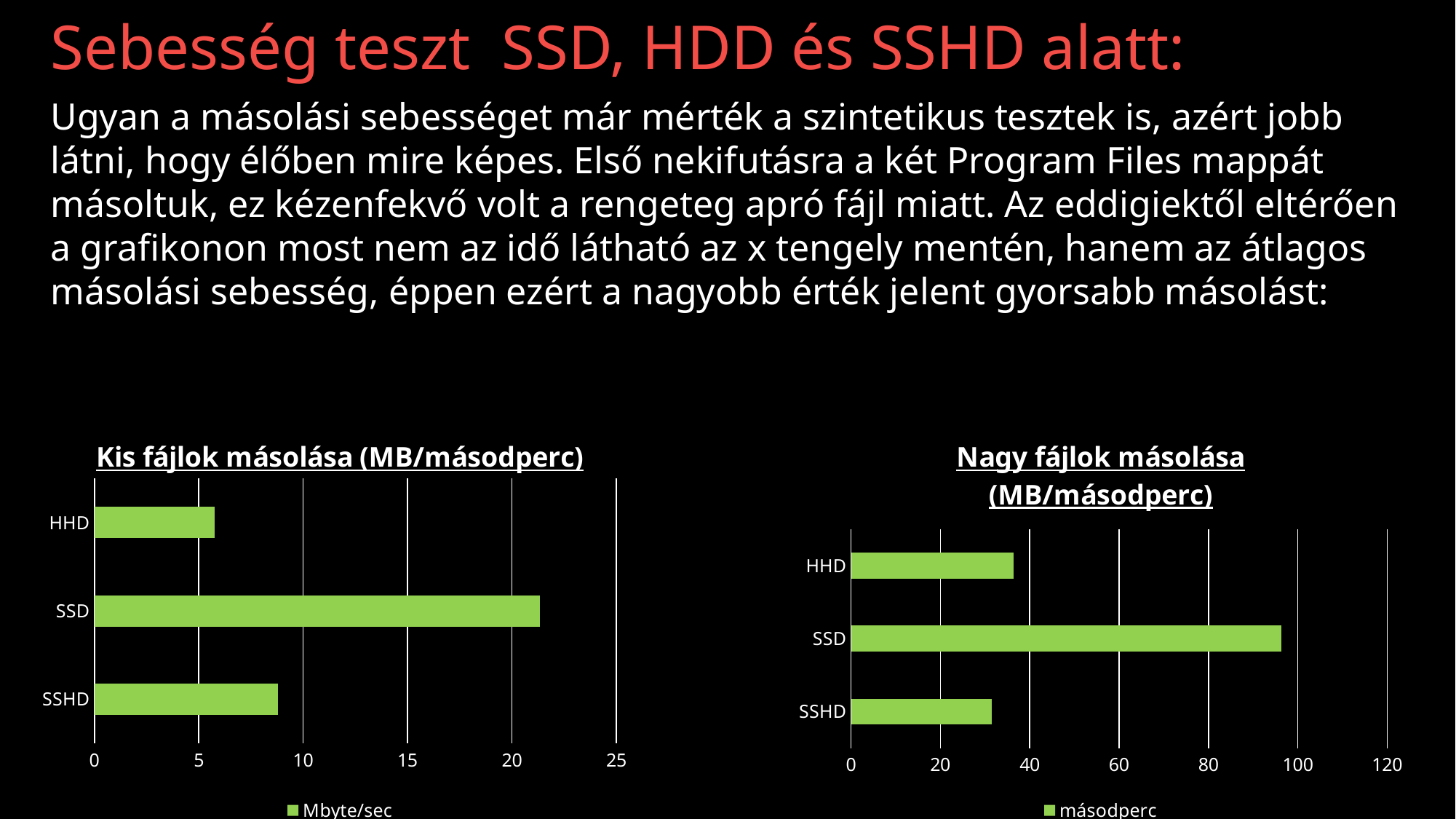
In the 'Kis fájlok másolása (MB/másodperc)' chart, which category has the highest value? SSD In the 'Kis fájlok másolása (MB/másodperc)' chart, which category has the lowest value? HHD In the 'Kis fájlok másolása (MB/másodperc)' chart, is the value for SSD greater or less than 20? greater In the 'Kis fájlok másolása (MB/másodperc)' chart, which is larger, the value for SSHD or the value for HHD? SSHD How many categories are shown in the 'Kis fájlok másolása (MB/másodperc)' chart? 3 In the 'Nagy fájlok másolása (MB/másodperc)' chart, which category has the highest value? SSD What is the legend entry of the 'Kis fájlok másolása (MB/másodperc)' chart? Mbyte/sec In the 'Kis fájlok másolása (MB/másodperc)' chart, is the value for SSHD greater or less than 10? less How many series does the legend of the 'Nagy fájlok másolása (MB/másodperc)' chart list? 1 In the 'Nagy fájlok másolása (MB/másodperc)' chart, is the value for SSD greater or less than 100? less What kind of chart is the 'Kis fájlok másolása (MB/másodperc)' chart? bar chart